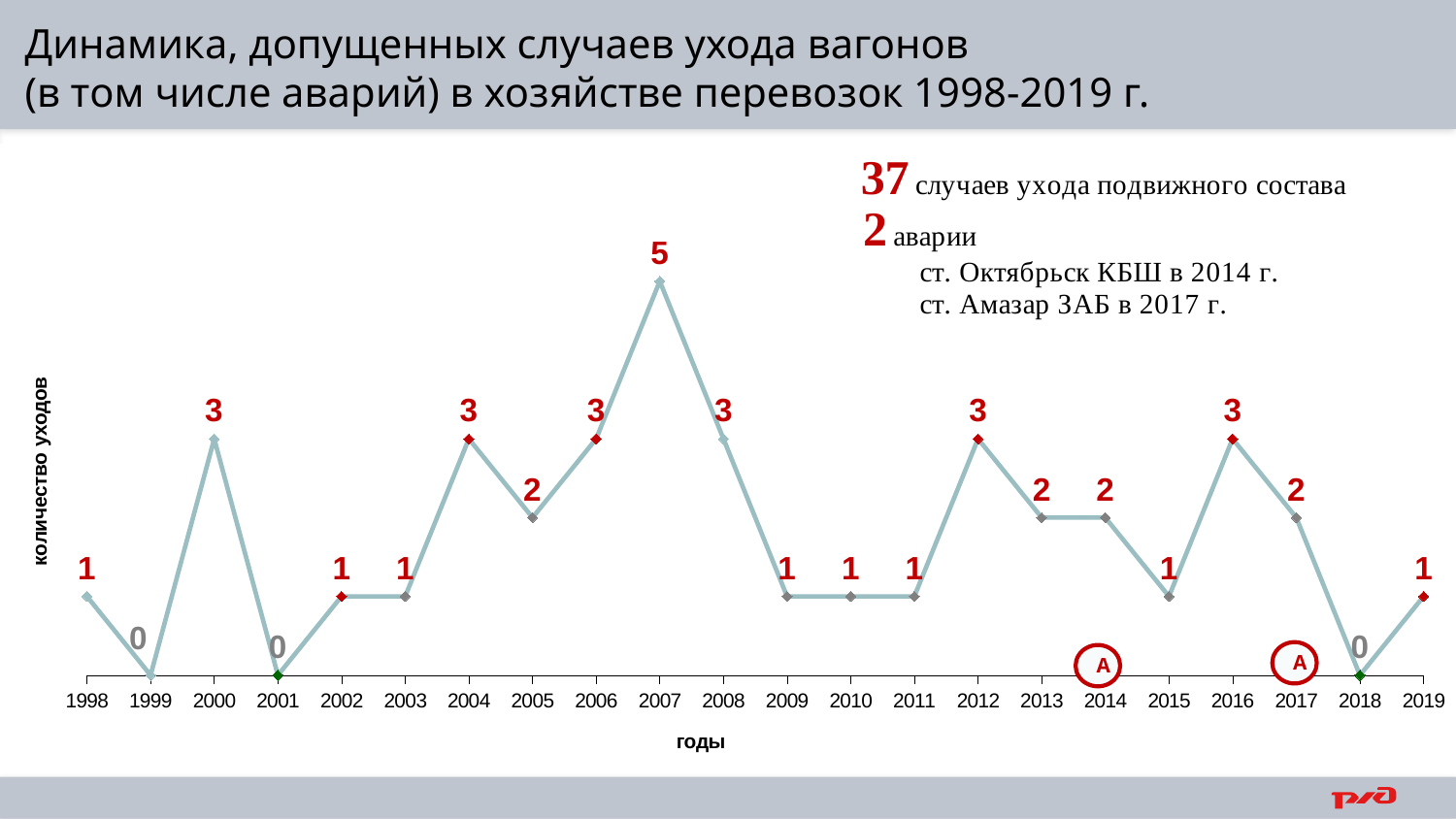
What is the label of the x axis? годы What is the difference between the values for 2016 and 2017? 1 What is the value for 2012? 3 What is the difference between the values for 2007 and 2008? 2 Which is larger, the value for 2000 or the value for 2001? 2000 What type of chart is shown on the slide? line chart Do the values rise or fall from 2016 to 2018? fall What is the value for 2007? 5 What is the value for 2005? 2 Which year has the highest value? 2007 How many years are plotted on the x axis? 22 What is the value for 2018? 0